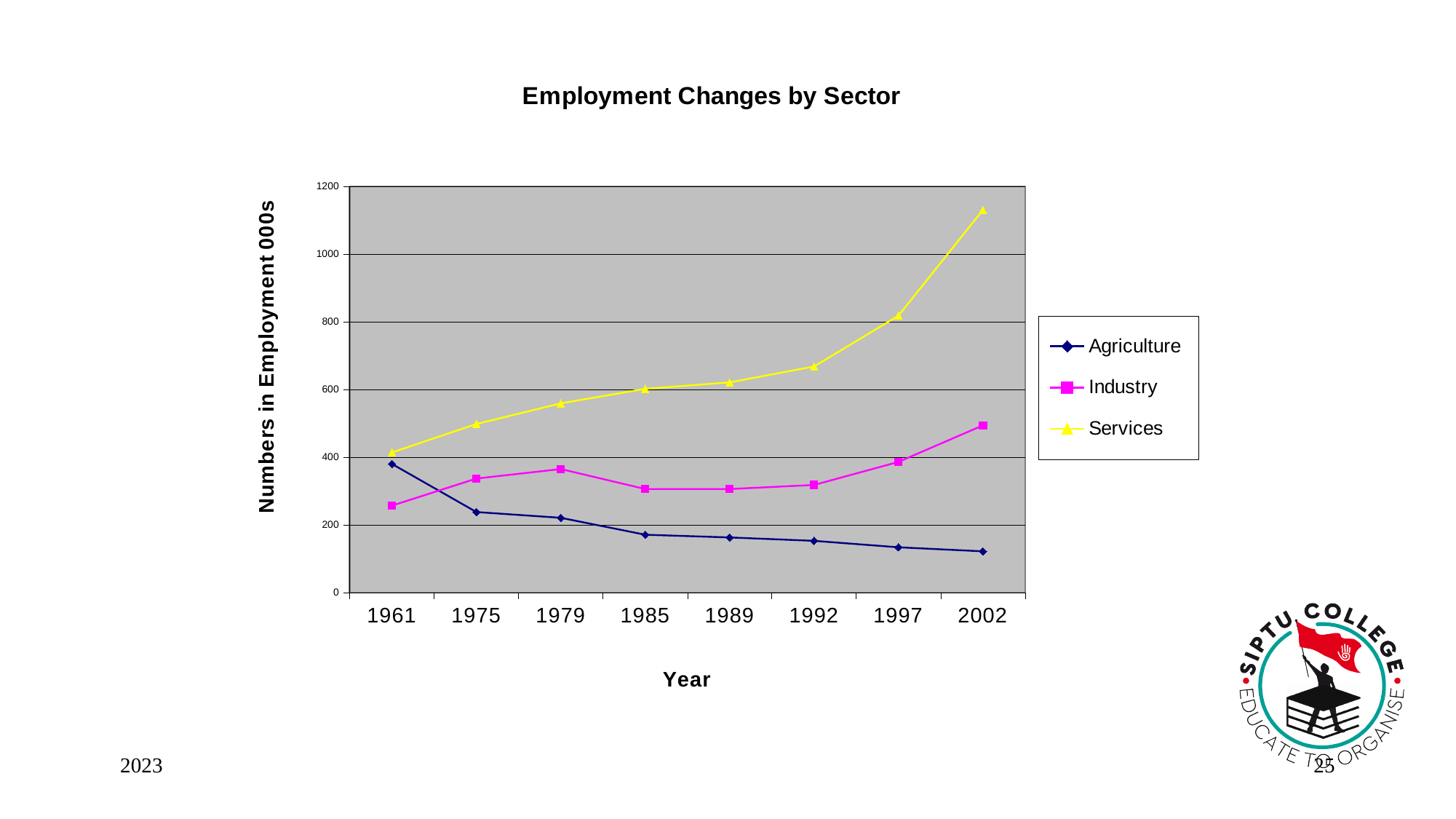
What kind of chart is shown on the slide? Line chart What is the title of the chart? Employment Changes by Sector How many years are shown on the x axis? 8 Does the Agriculture line rise or fall from 1961 to 2002? Fall What is the label on the vertical axis? Numbers in Employment 000s Is the value for Services in 1961 greater or less than 600? less Is the value for Agriculture in 2002 greater or less than 200? less In which year is the Agriculture value lowest? 2002 Which sector has the highest value in 2002? Services Is the value for Industry in 2002 greater or less than 400? greater How many series does the legend list? 3